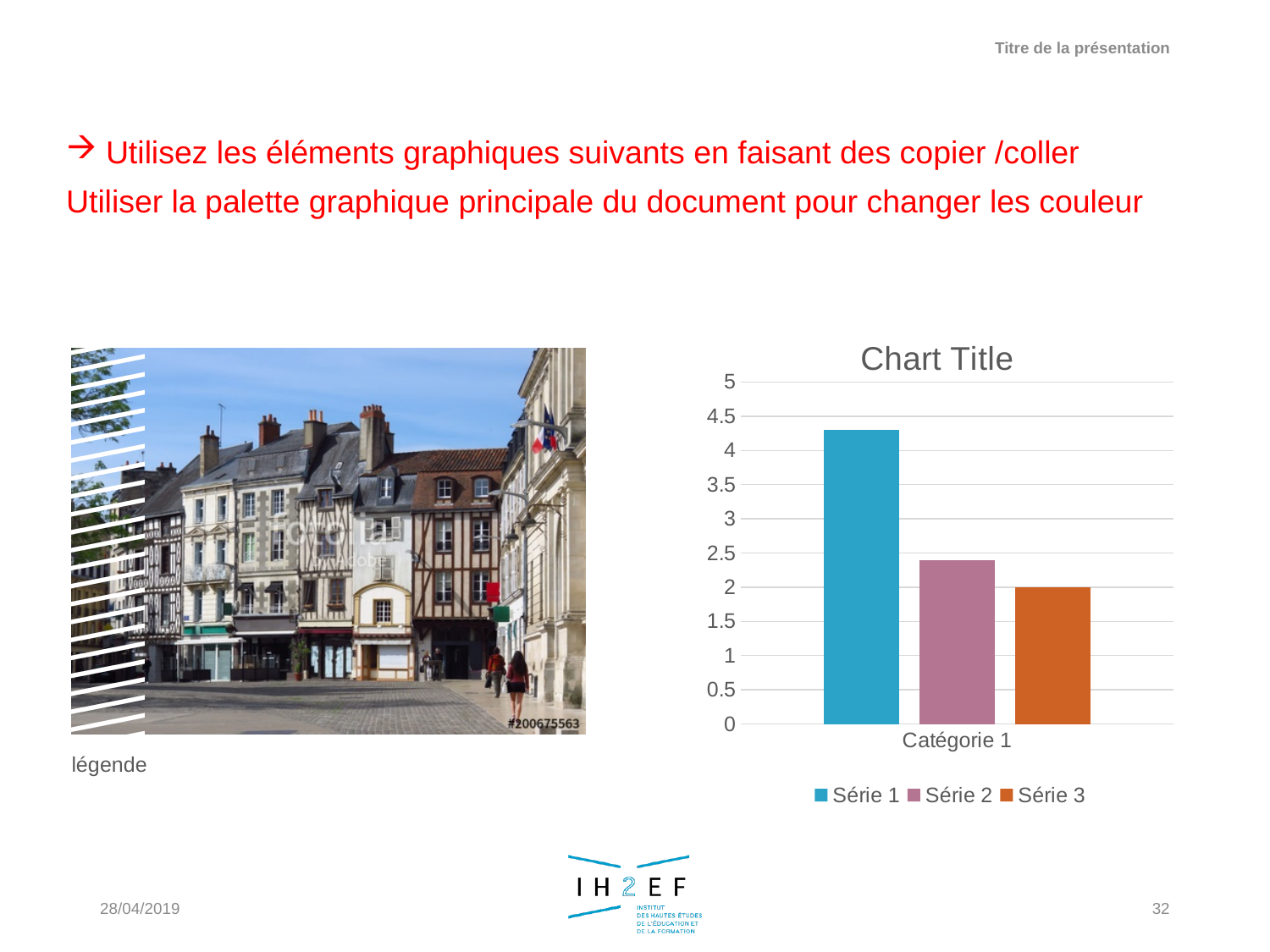
Which series has the highest value for Catégorie 1? Série 1 Is the value for Série 1 greater or less than 4? greater What is the label of the category on the x axis? Catégorie 1 Is the value for Série 1 greater or less than 4.5? less How many categories are shown on the x axis of the chart? 1 Is the value for Série 2 greater or less than 3? less What is the title of the chart? Chart Title How many series does the chart legend list? 3 What is the value for Série 3 in Catégorie 1? 2 Which series has the lowest value for Catégorie 1? Série 3 Which is larger for Catégorie 1, Série 1 or Série 2? Série 1 What kind of chart is shown on the slide? bar chart